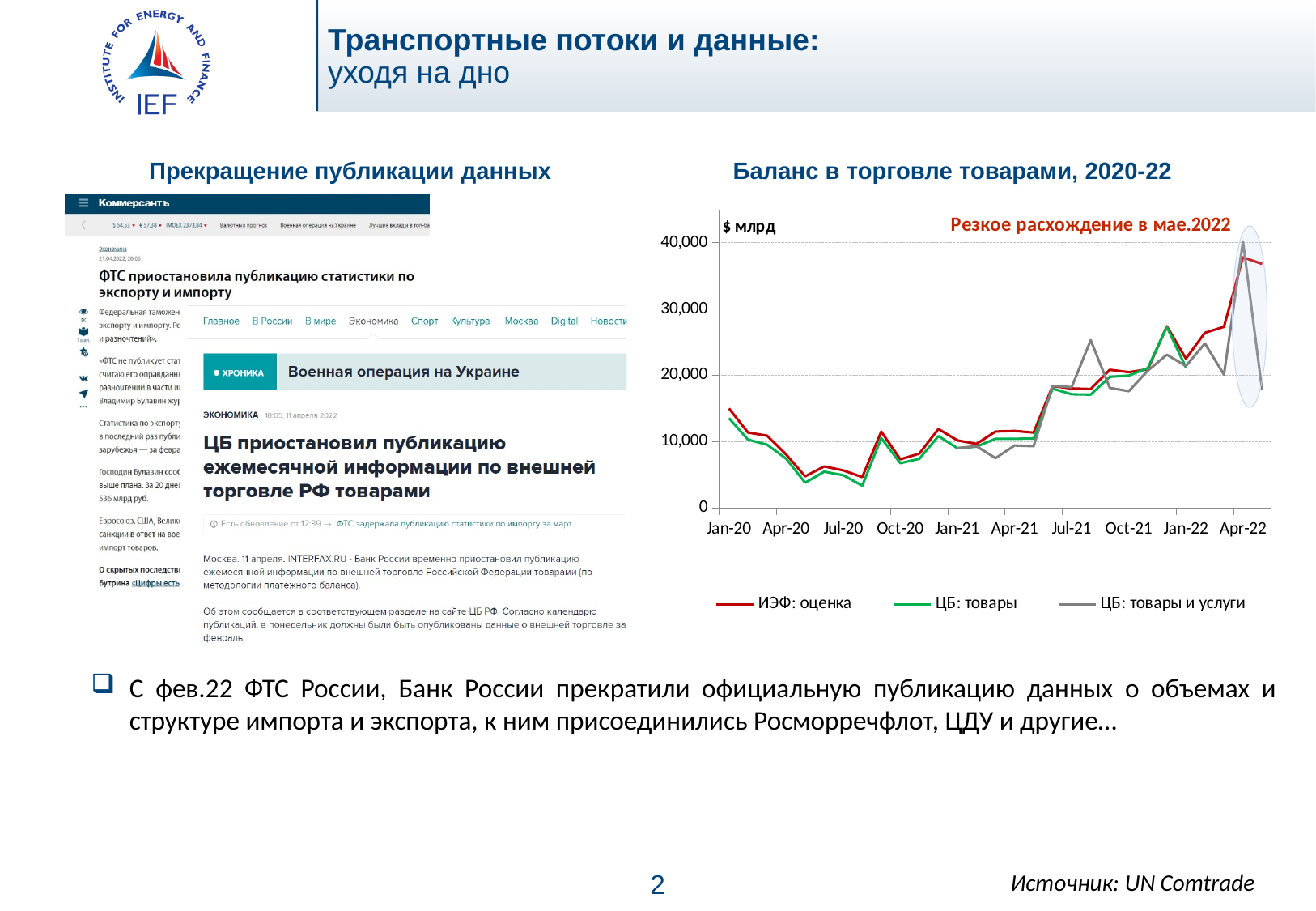
In the chart 'Баланс в торговле товарами, 2020-22', is the value of 'ИЭФ: оценка' at Jan-22 greater or less than 30,000? less In the chart 'Баланс в торговле товарами, 2020-22', at Jul-21 which series is higher: 'ЦБ: товары и услуги' or 'ЦБ: товары'? ЦБ: товары и услуги In the chart 'Баланс в торговле товарами, 2020-22', is the value of 'ИЭФ: оценка' at Jan-20 greater or less than 10,000? greater In the chart 'Баланс в торговле товарами, 2020-22', do the values of 'ИЭФ: оценка' generally rise or fall from Jan-20 to Apr-22? rise In the chart 'Баланс в торговле товарами, 2020-22', is the value of 'ИЭФ: оценка' at Apr-22 greater or less than 20,000? greater What unit label is shown at the top of the y axis of the chart 'Баланс в торговле товарами, 2020-22'? $ млрд What kind of chart is 'Баланс в торговле товарами, 2020-22'? line chart How many series does the legend of the chart 'Баланс в торговле товарами, 2020-22' list? 3 In the chart 'Баланс в торговле товарами, 2020-22', which series is drawn in red? ИЭФ: оценка How many labels are shown on the x axis of the chart 'Баланс в торговле товарами, 2020-22'? 10